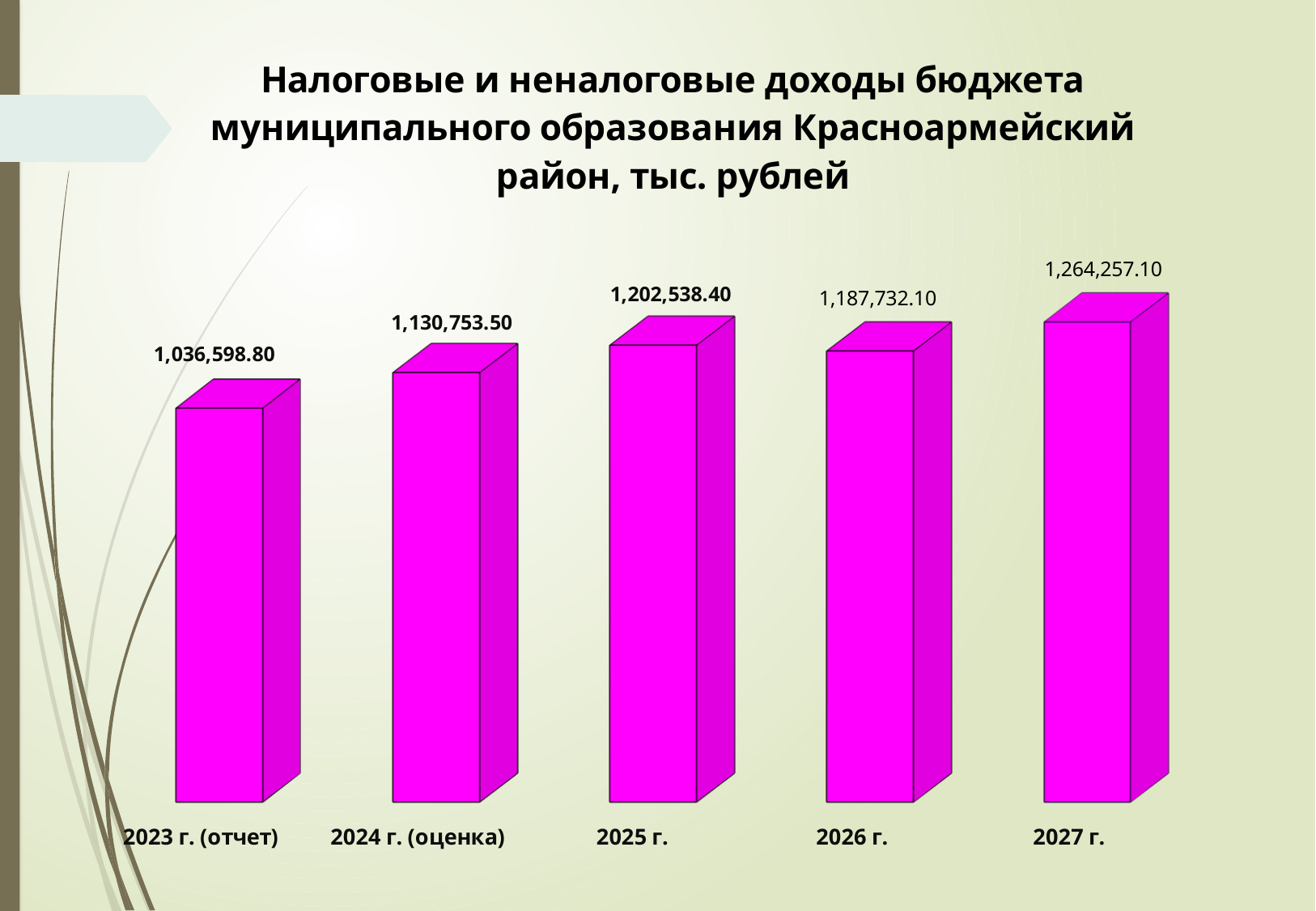
Which is larger, the value for 2025 г. or the value for 2026 г.? 2025 г. Which year has the lowest value? 2023 г. (отчет) What is the value for 2023 г. (отчет)? 1,036,598.80 What is the value for 2027 г.? 1,264,257.10 What is the value for 2025 г.? 1,202,538.40 What is the value for 2026 г.? 1,187,732.10 How many bars are shown in the chart? 5 What kind of chart is shown on the slide? Bar chart What is the value for 2024 г. (оценка)? 1,130,753.50 What is the difference between the values for 2024 г. (оценка) and 2023 г. (отчет)? 94,154.70 Which year has the highest value? 2027 г. What is the difference between the values for 2027 г. and 2026 г.? 76,525.00